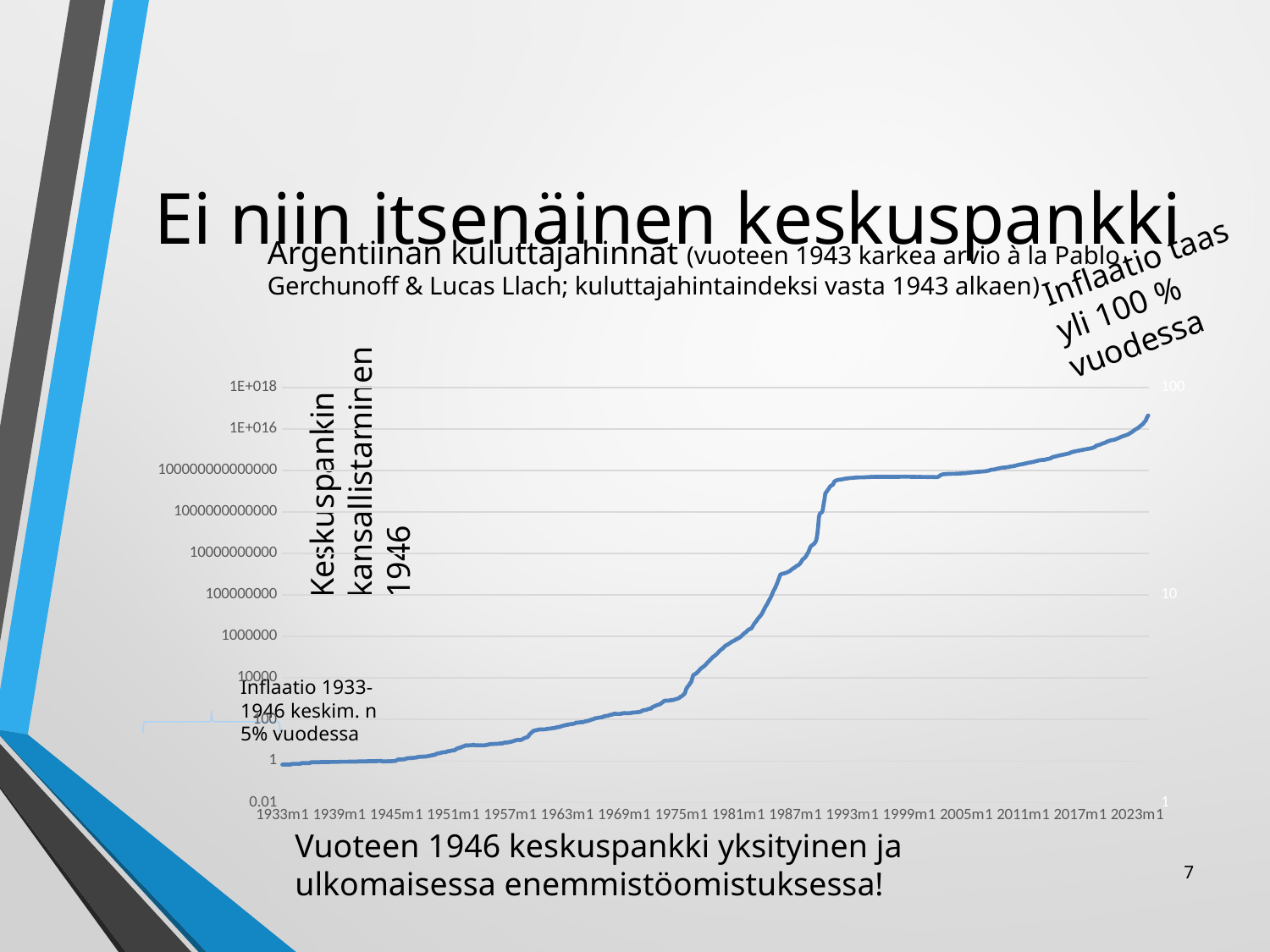
Which year does the annotation on the chart give for the nationalisation of the central bank (Keskuspankin kansallistaminen)? 1946 Is the value at 1933m1 greater or less than 100? less Do the plotted values rise or fall along the x axis from 1933m1 to 2023m1? rise What is the last label on the x axis? 2023m1 What kind of chart is shown on the slide? line chart What is the first label on the x axis? 1933m1 What is the title of the chart? Argentiinan kuluttajahinnat Is the value at 1993m1 greater or less than 1000000000000? greater How many lines are plotted on the chart? 2 Is the value at 1963m1 greater or less than 1000000? less How many labels are shown on the x axis? 16